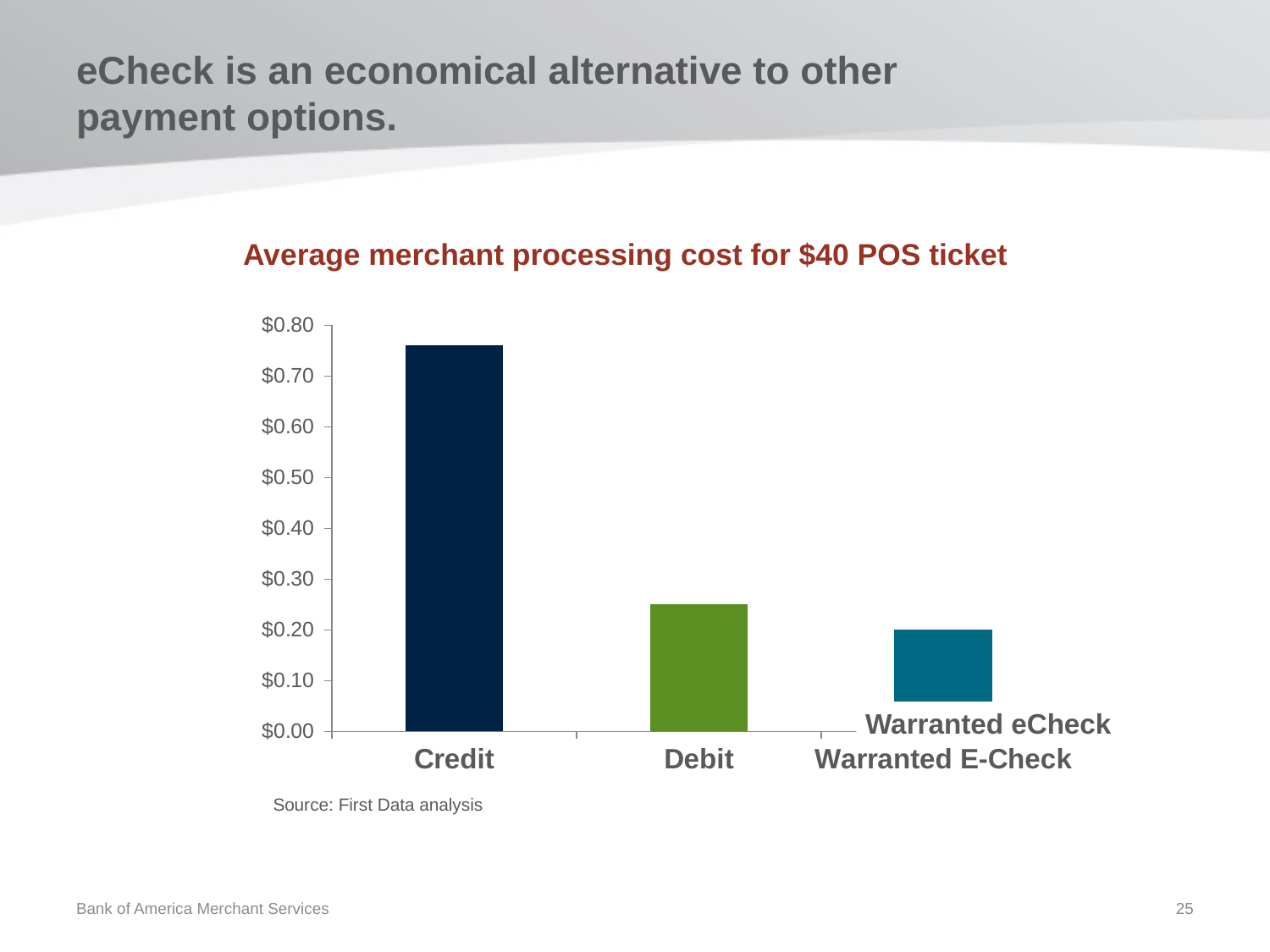
What source is cited below the chart? First Data analysis What kind of chart is shown on the slide? Bar chart Which payment option has the lowest average merchant processing cost? Warranted E-Check How many categories are plotted in the chart? 3 Is the value for Warranted E-Check greater or less than $0.40? less Is the value for Credit greater or less than $0.70? greater Which payment option has the highest average merchant processing cost? Credit Which has a higher processing cost, Credit or Debit? Credit Do the bar values rise or fall moving from left to right across the categories? Fall What is the title of the chart? Average merchant processing cost for $40 POS ticket Is the value for Debit greater or less than $0.30? less Which has a higher processing cost, Debit or Warranted E-Check? Debit